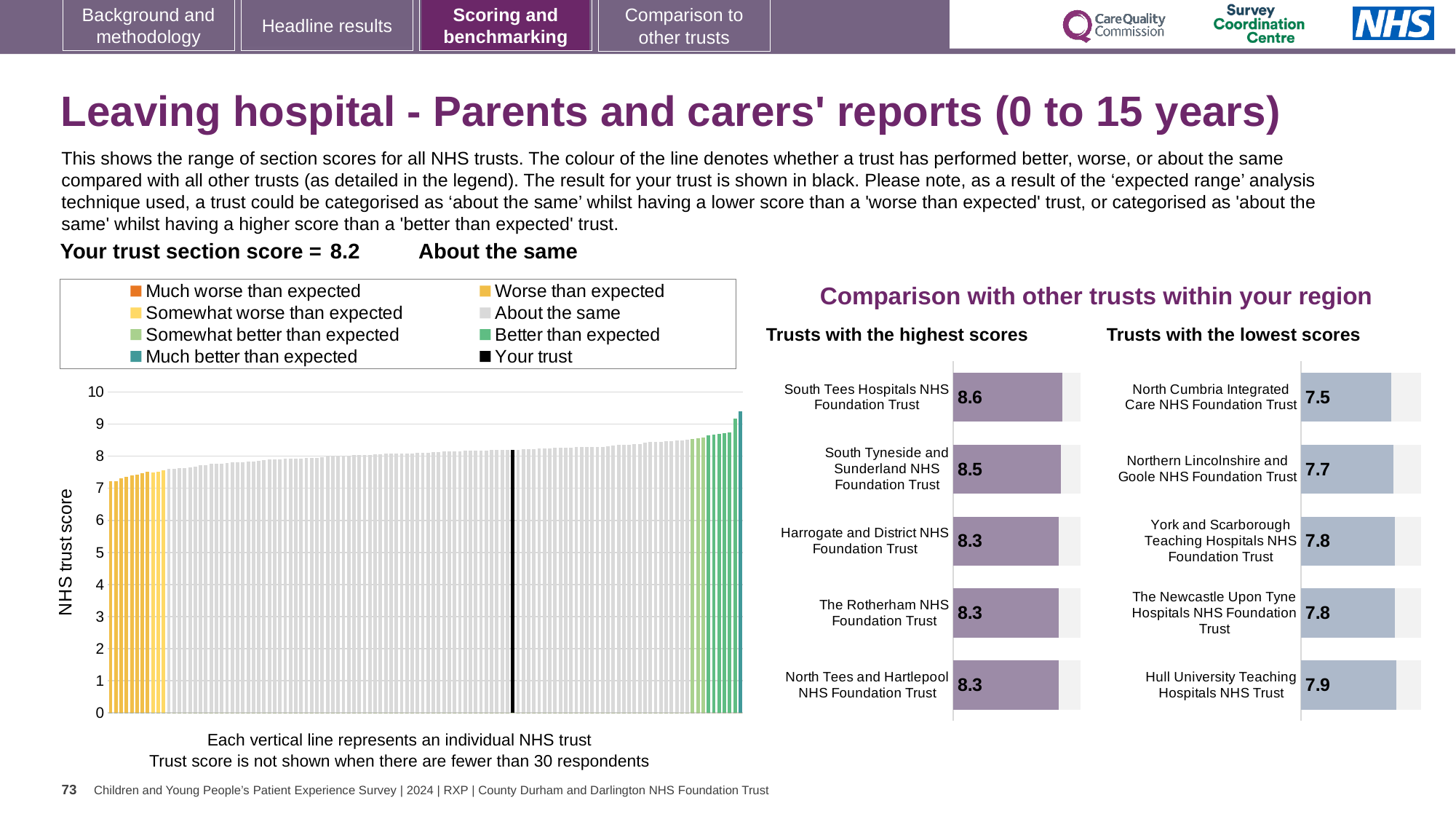
What kind of chart is the large chart on the left showing NHS trust scores? Bar chart In the 'Trusts with the highest scores' chart, what is the score for South Tees Hospitals NHS Foundation Trust? 8.6 In the left-hand chart, is the value of the tallest bar greater or less than 9? greater In the 'Trusts with the lowest scores' chart, what is the score for North Cumbria Integrated Care NHS Foundation Trust? 7.5 In the 'Trusts with the lowest scores' chart, which trust has the lowest score? North Cumbria Integrated Care NHS Foundation Trust How many entries does the legend of the left-hand chart list? 8 What is the y-axis label of the left-hand chart? NHS trust score In the 'Trusts with the lowest scores' chart, what is the score for The Newcastle Upon Tyne Hospitals NHS Foundation Trust? 7.8 In the 'Trusts with the highest scores' chart, what is the difference between the scores of South Tees Hospitals NHS Foundation Trust and North Tees and Hartlepool NHS Foundation Trust? 0.3 How many trusts are shown in the 'Trusts with the highest scores' chart? 5 In the 'Trusts with the lowest scores' chart, which has the higher score: Hull University Teaching Hospitals NHS Trust or Northern Lincolnshire and Goole NHS Foundation Trust? Hull University Teaching Hospitals NHS Trust In the 'Trusts with the highest scores' chart, which trust has the highest score? South Tees Hospitals NHS Foundation Trust